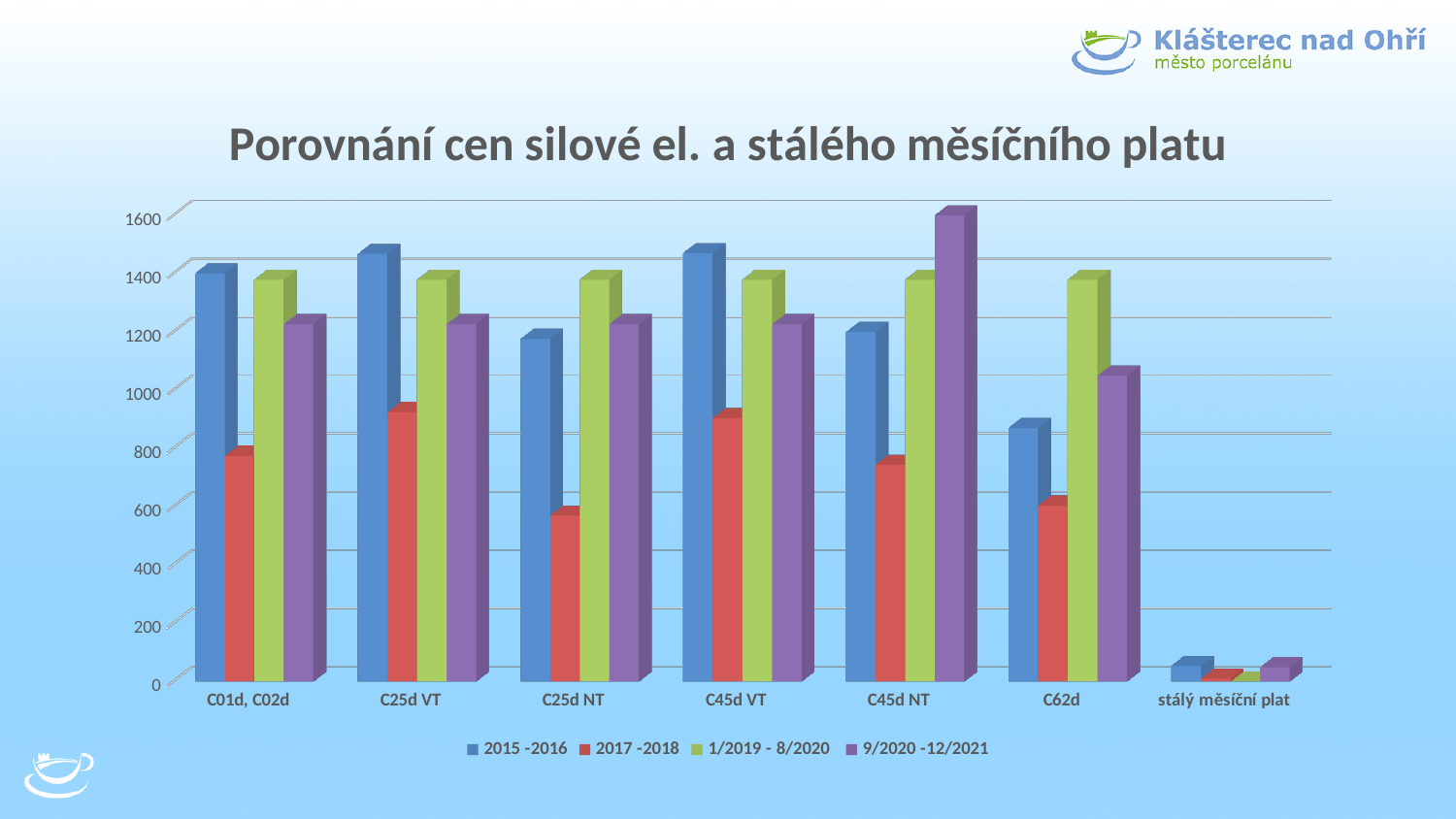
Which category has the lowest value for the 2015 -2016 series? stálý měsíční plat How many series does the legend list? 4 Is the 2015 -2016 value for C62d greater or less than 1000? less For C45d NT, which is larger: the 1/2019 - 8/2020 value or the 9/2020 -12/2021 value? 9/2020 -12/2021 Which category has the highest value for the 9/2020 -12/2021 series? C45d NT Is the 2017 -2018 value for C25d NT greater or less than 800? less What kind of chart is shown on the slide? bar chart Among the tariff categories other than stálý měsíční plat, which has the lowest 2015 -2016 value? C62d What is the title of the chart? Porovnání cen silové el. a stálého měsíčního platu For C01d, C02d, which is larger: the 2015 -2016 value or the 2017 -2018 value? 2015 -2016 Is the 9/2020 -12/2021 value for C45d NT greater or less than 1400? greater How many categories are shown on the x axis? 7